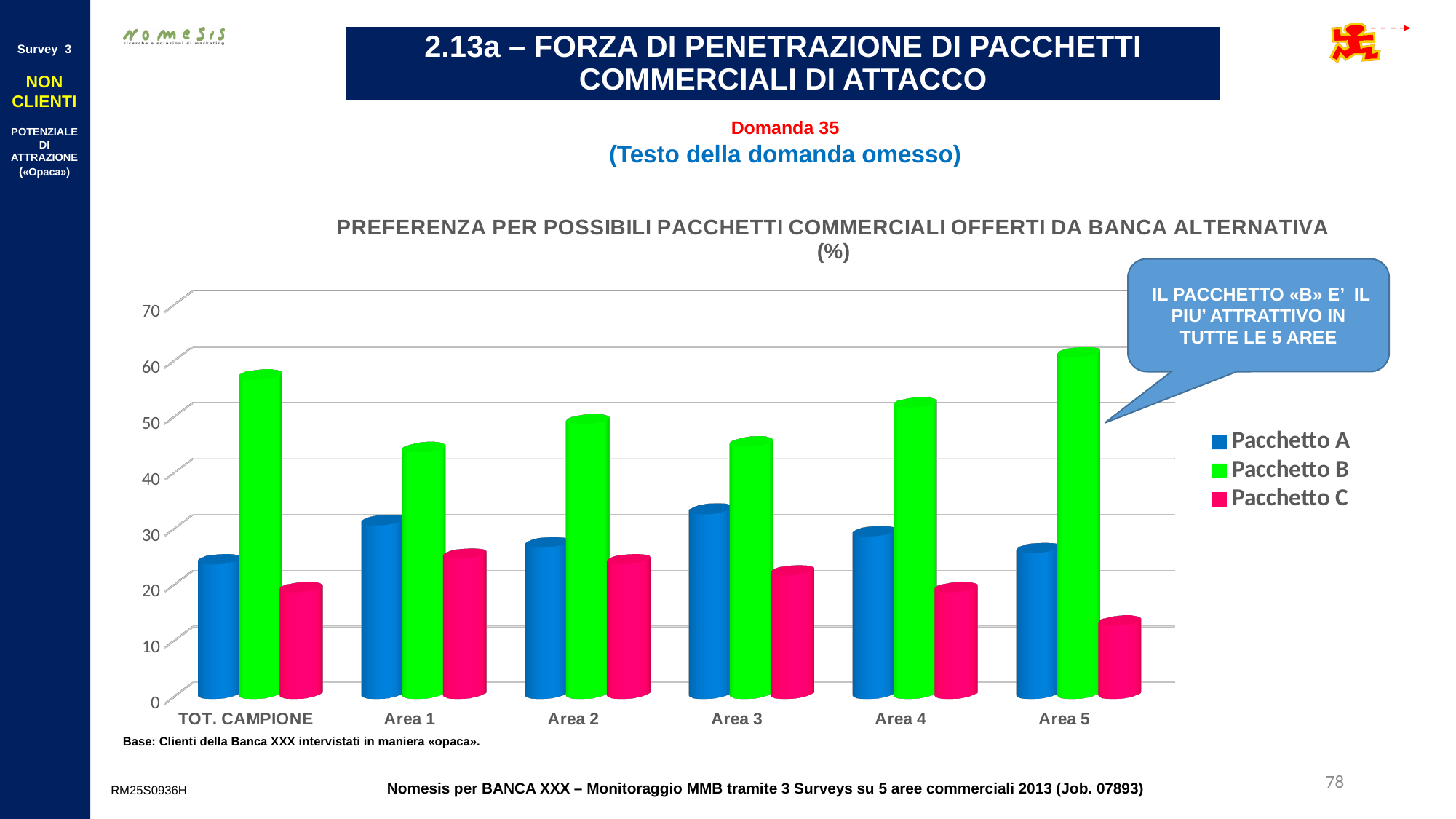
Which is larger for Pacchetto B: Area 5 or TOT. CAMPIONE? Area 5 In which category is the value for Pacchetto C the lowest? Area 5 How many categories are shown on the x axis? 6 Which series has the highest value in every category? Pacchetto B How many series does the legend list? 3 What kind of chart is shown on the slide? Bar chart Is the value for Pacchetto B in TOT. CAMPIONE greater or less than 50? greater In which category is the value for Pacchetto B the highest? Area 5 In Area 3, which is larger: Pacchetto A or Pacchetto C? Pacchetto A Is the value for Pacchetto C in Area 5 greater or less than 20? less What colour represents Pacchetto B in the legend? Green Is the value for Pacchetto B in Area 1 greater or less than 50? less